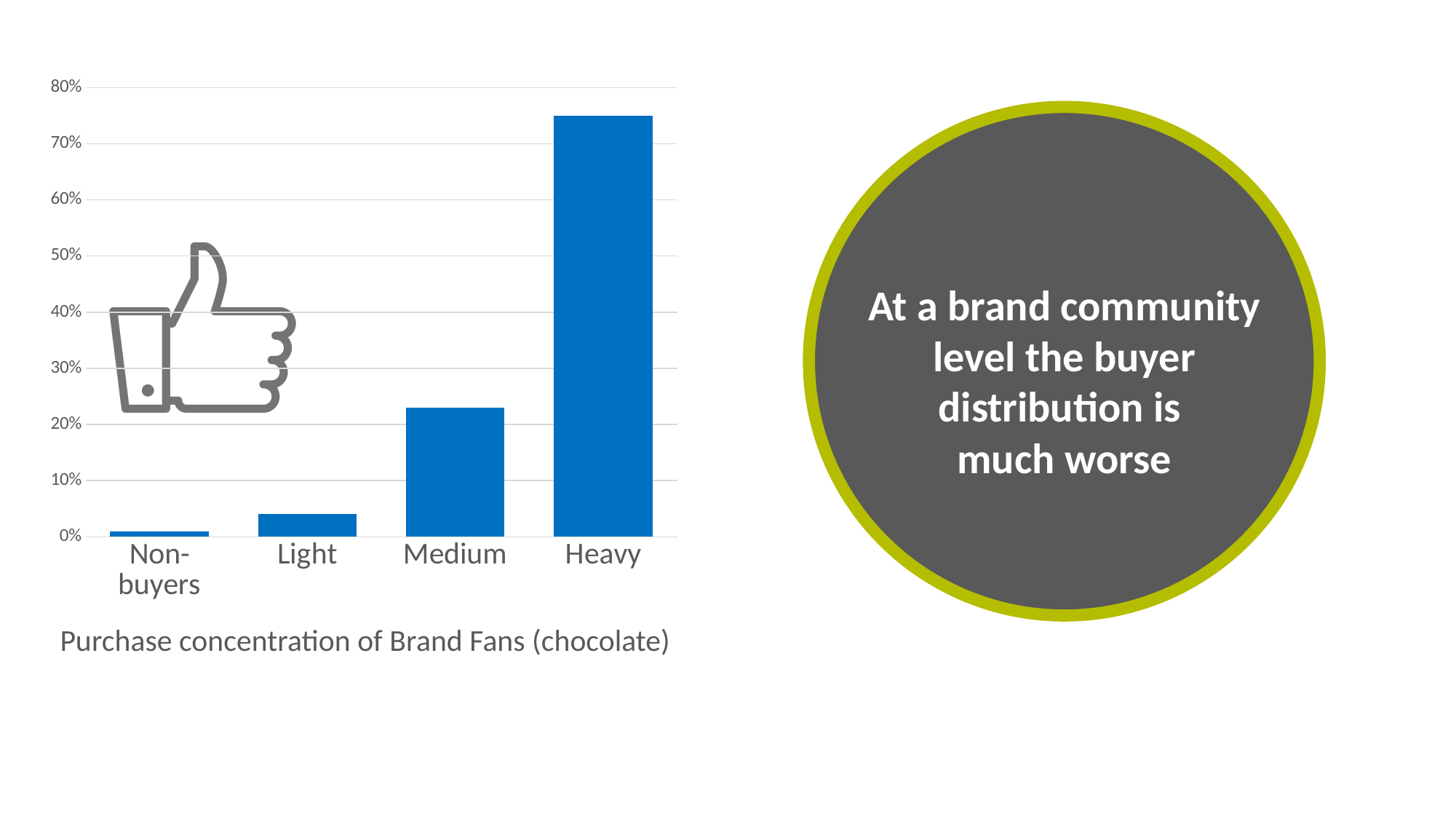
Is the value for Medium greater or less than 30%? less Is the value for Medium greater or less than 20%? greater Is the value for Heavy greater or less than 70%? greater What is the caption printed below the chart? Purchase concentration of Brand Fans (chocolate) Which category has the highest value in the chart? Heavy What kind of chart is shown on the slide? bar chart Which is larger, the value for Medium or the value for Light? Medium How many categories are shown on the x axis of the chart? 4 Do the values rise or fall moving from Non-buyers to Heavy along the x axis? rise Which category has the lowest value in the chart? Non-buyers What is the highest value shown on the chart's vertical axis? 80%